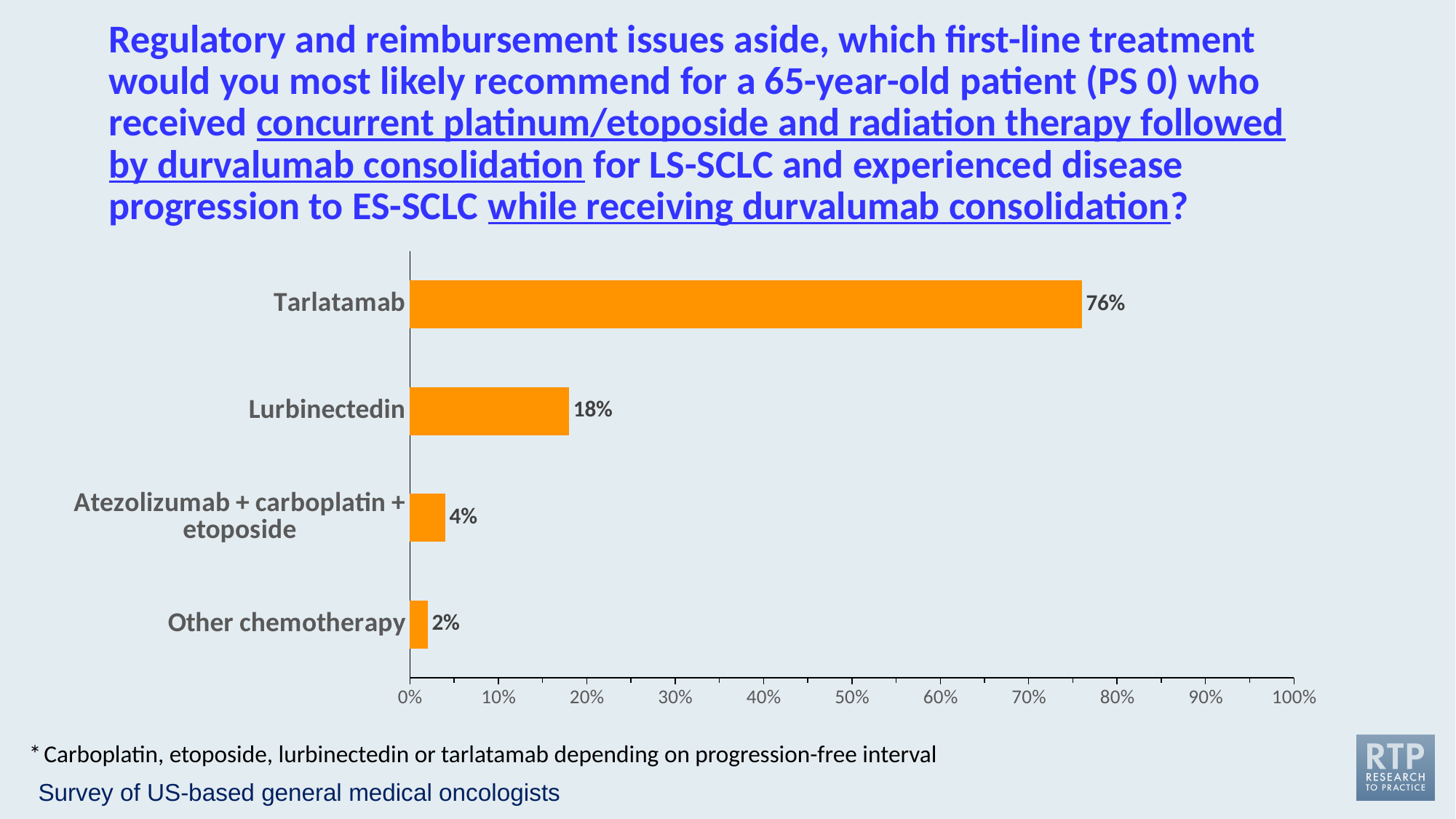
What is the maximum value shown on the horizontal axis? 100% Which received a larger share of responses, Lurbinectedin or Atezolizumab + carboplatin + etoposide? Lurbinectedin Which treatment option received the highest percentage of responses? Tarlatamab What is the difference in percentage points between Tarlatamab and Lurbinectedin? 58 Which treatment option received the lowest percentage of responses? Other chemotherapy How many treatment options are shown in the chart? 4 Is the value for Tarlatamab greater or less than 70%? greater What percentage of respondents chose Atezolizumab + carboplatin + etoposide? 4% What percentage of respondents would recommend Tarlatamab? 76% What percentage of respondents would recommend Lurbinectedin? 18% What type of chart is shown on the slide? Bar chart What percentage of respondents chose Other chemotherapy? 2%